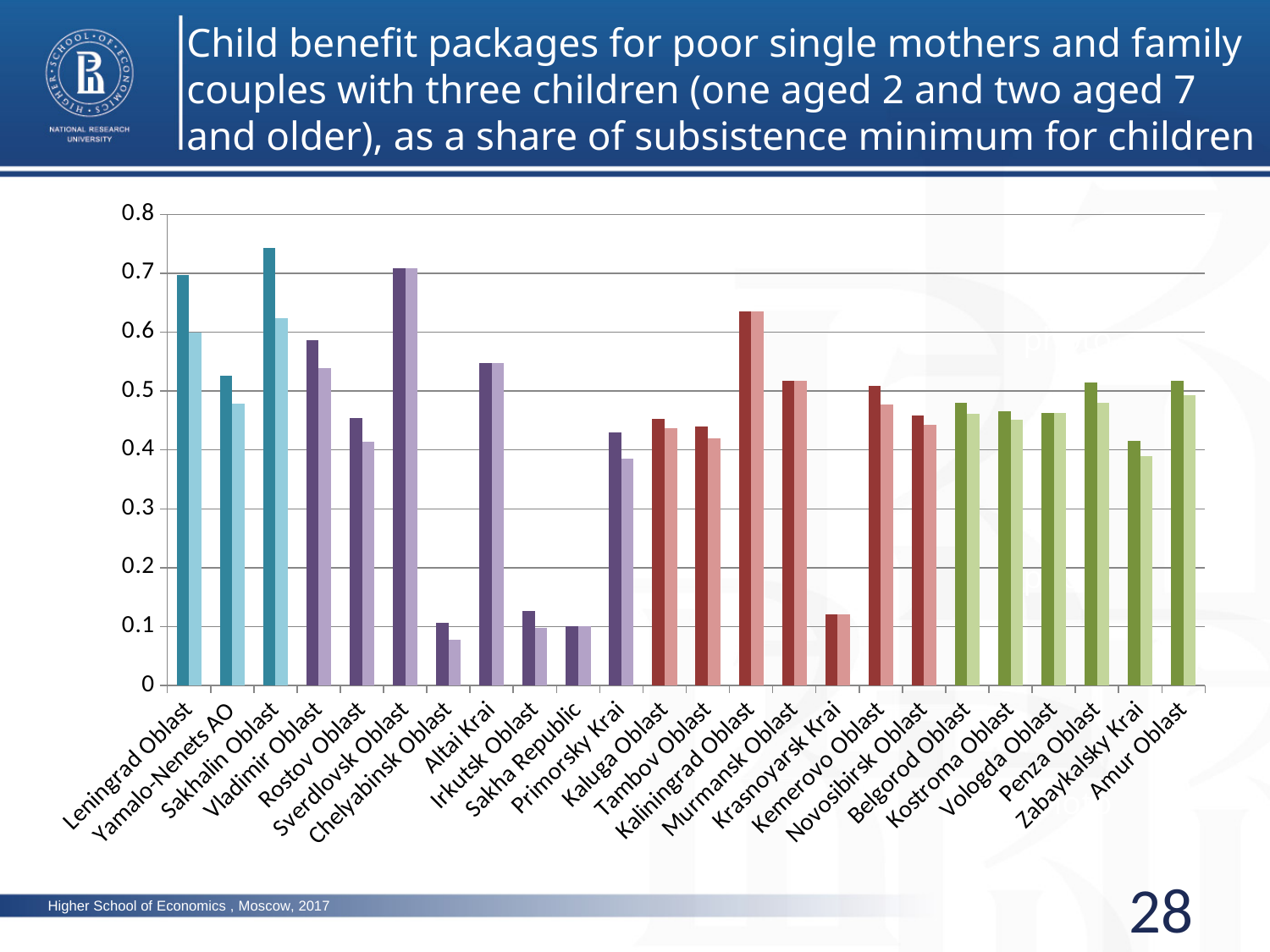
What kind of chart is shown on the slide? bar chart How many bars are plotted for each region in the chart? 2 Is the dark bar for Kaliningrad Oblast greater or less than 0.6? greater Which has the taller dark bar, Kaliningrad Oblast or Murmansk Oblast? Kaliningrad Oblast How many regions are shown along the x axis of the chart? 24 Is the dark bar for Leningrad Oblast greater or less than 0.6? greater Is the dark bar for Krasnoyarsk Krai greater or less than 0.2? less What is the highest value shown on the vertical axis of the chart? 0.8 Which region has the tallest light-coloured bar in the chart? Sverdlovsk Oblast Which region has the tallest dark-coloured bar in the chart? Sakhalin Oblast